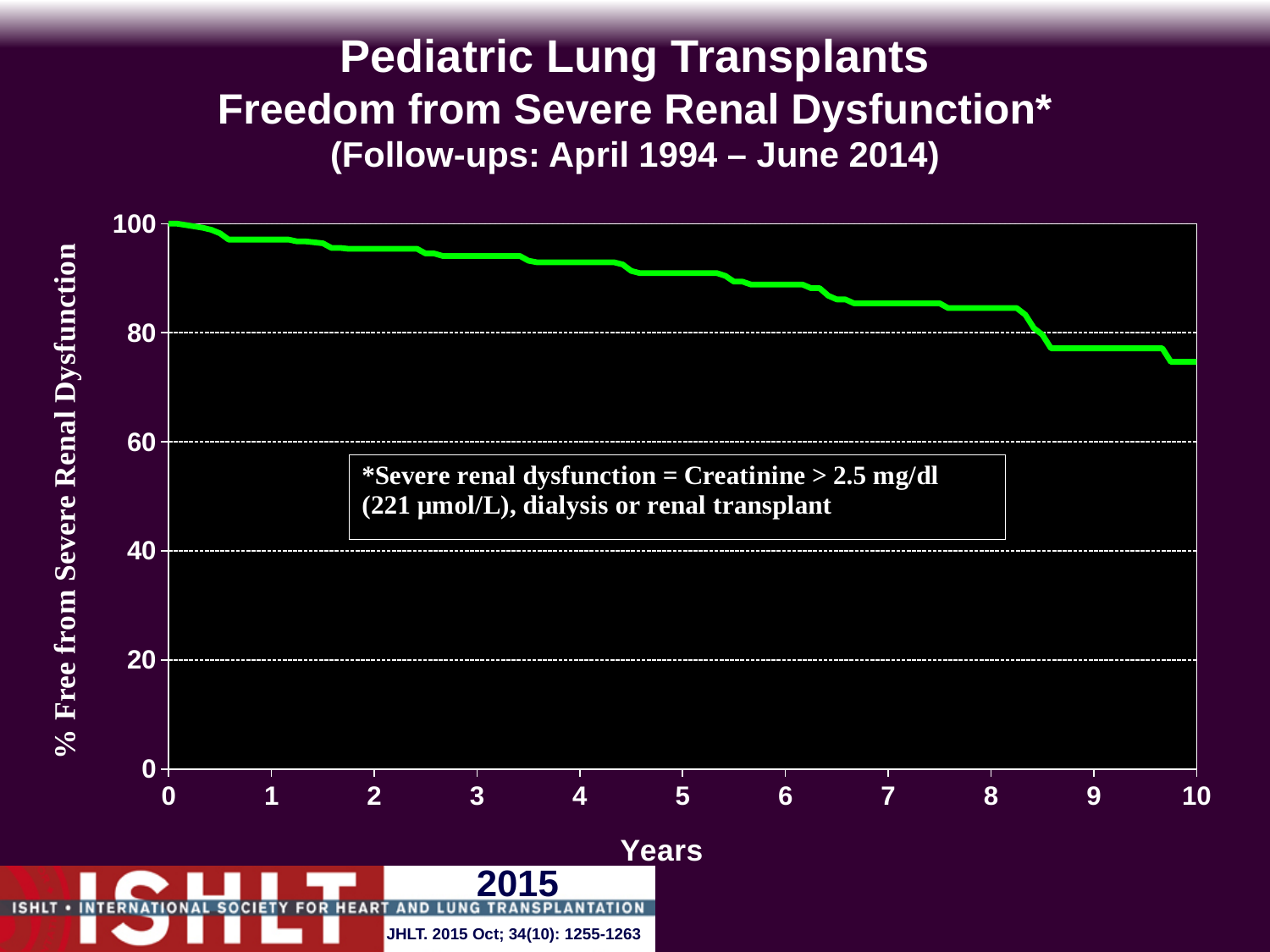
What kind of chart is shown on the slide? line chart Is the value for year 10 greater or less than 80? less Is the value for year 5 greater or less than 80? greater Is the value for year 9 greater or less than 80? less What is the highest value shown on the y axis? 100 Does the plotted line rise or fall as the years increase along the x axis? fall What is the value of the line at year 0? 100 What is the label of the x axis? Years Which is larger, the value at year 3 or the value at year 9? year 3